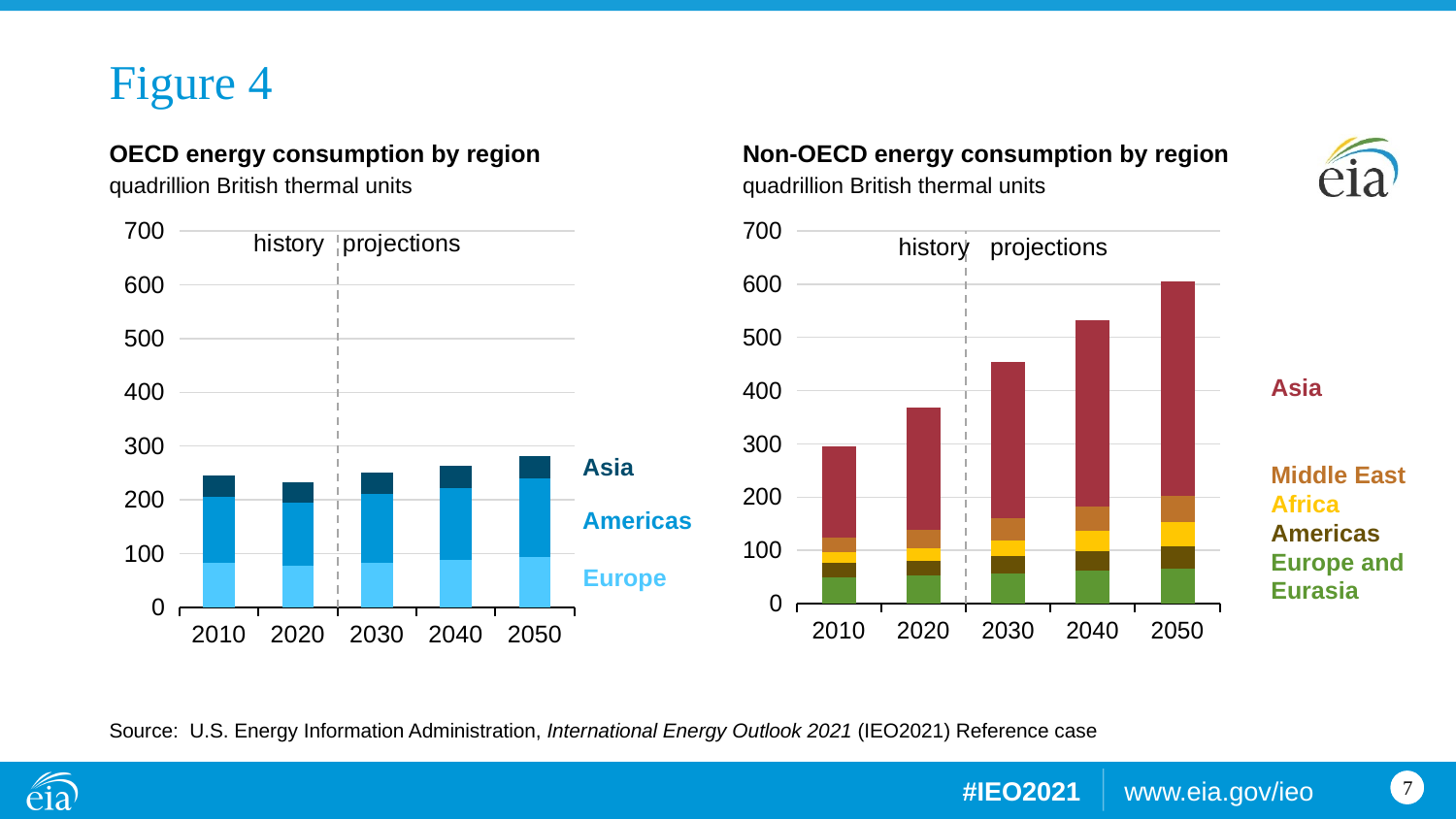
What kind of chart is the 'OECD energy consumption by region' chart? stacked bar chart Which is larger: the total energy consumption in 2050 in the 'Non-OECD energy consumption by region' chart or in the 'OECD energy consumption by region' chart? Non-OECD In the 'Non-OECD energy consumption by region' chart, is the total for 2040 greater or less than 500? greater In the 'Non-OECD energy consumption by region' chart, which year has the highest total energy consumption? 2050 In the 'OECD energy consumption by region' chart, is the total for 2050 greater or less than 300? less In the 'OECD energy consumption by region' chart, which year has the highest total energy consumption? 2050 In the 'Non-OECD energy consumption by region' chart, do total values rise or fall from 2010 to 2050? rise In the 'Non-OECD energy consumption by region' chart, which region accounts for the largest segment of each bar? Asia How many series does the legend of the 'Non-OECD energy consumption by region' chart list? 5 How many series does the legend of the 'OECD energy consumption by region' chart list? 3 In the 'Non-OECD energy consumption by region' chart, which year has the lowest total energy consumption? 2010 How many years are plotted on the x axis of the 'Non-OECD energy consumption by region' chart? 5